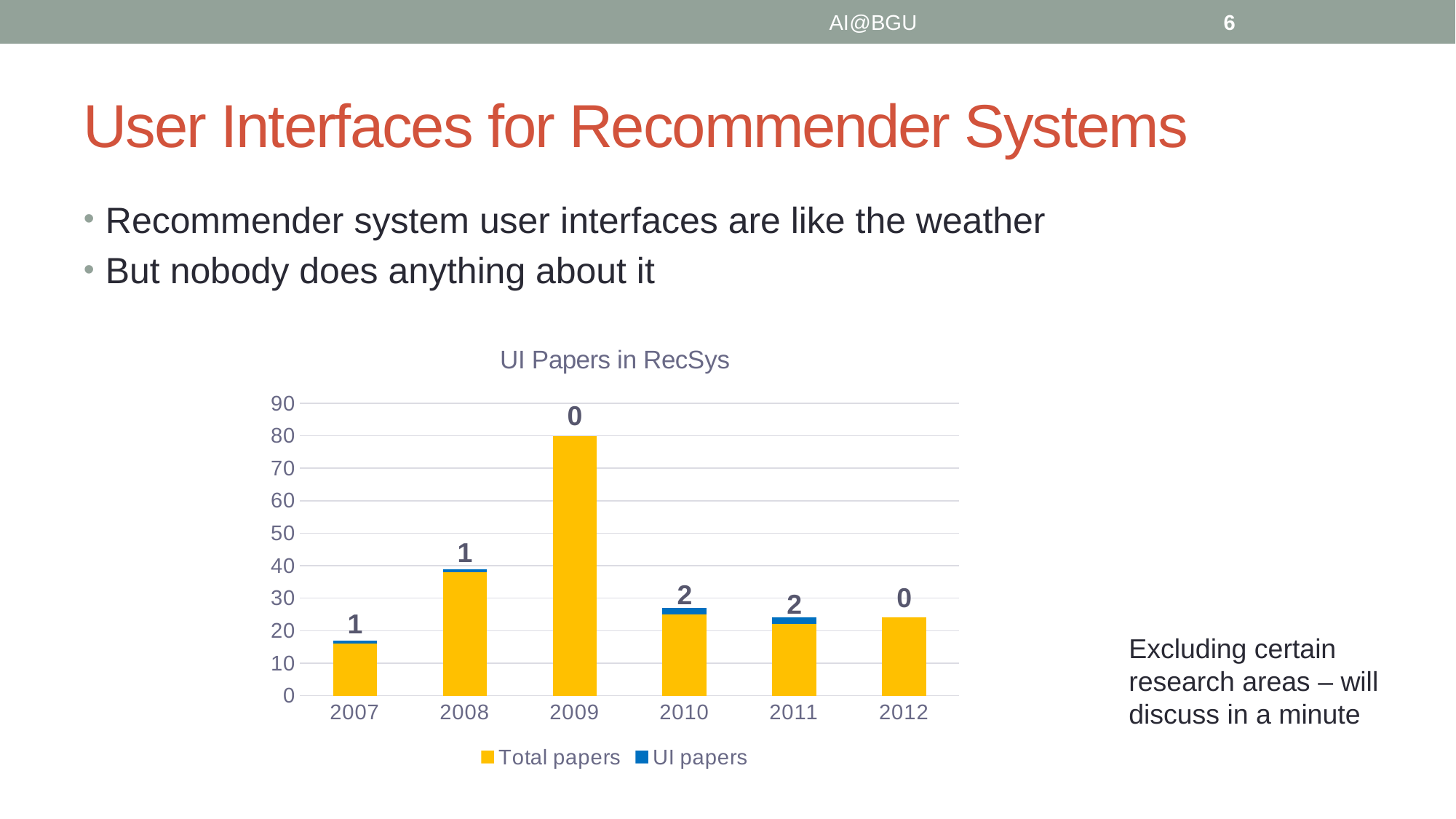
Is the total papers value for 2007 greater or less than 20? less How many years are shown on the x axis? 6 What is the difference in UI papers between 2010 and 2007? 1 What kind of chart is shown? bar chart What is the UI papers value for 2012? 0 How many series does the legend list? 2 How many UI papers are shown for 2010? 2 Which year has the lowest number of total papers? 2007 Which year has more total papers, 2008 or 2010? 2008 Is the total papers value for 2009 greater or less than 50? greater What is the UI papers value for 2009? 0 Which year has the highest number of total papers? 2009